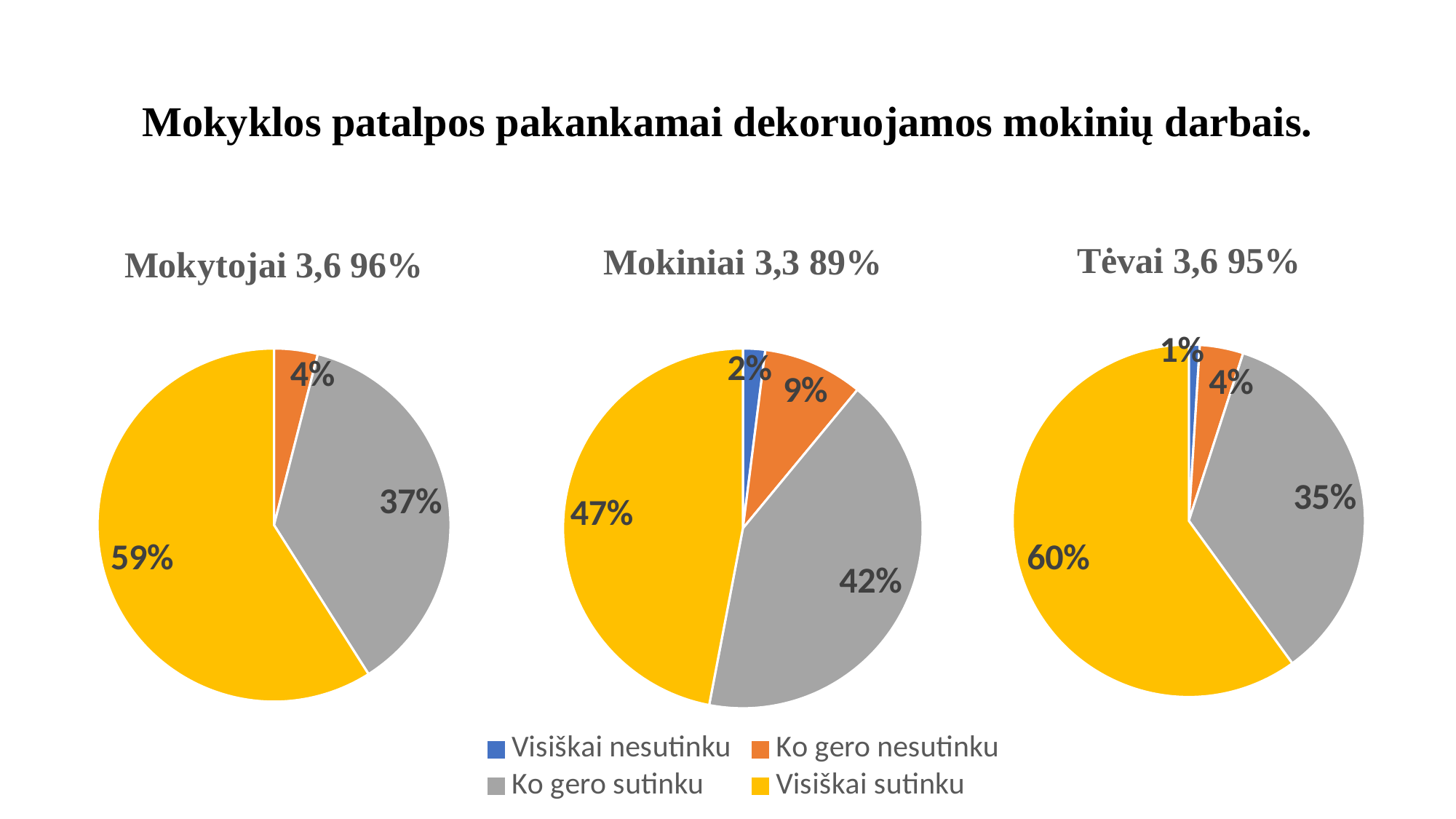
In the Tėvai pie chart, what share is labelled for Visiškai nesutinku? 1% In the Mokiniai pie chart, what share is labelled for Ko gero sutinku? 42% How many entries does the legend list? 4 How many slices with labels does the Mokiniai pie chart have? 4 In the Mokiniai pie chart, which category has the largest slice? Visiškai sutinku In the Mokytojai pie chart, what is the difference between the Visiškai sutinku and Ko gero sutinku shares? 22 percentage points In the Mokytojai pie chart, what share is labelled for Visiškai sutinku? 59% What is the title of the slide? Mokyklos patalpos pakankamai dekoruojamos mokinių darbais. Which colour represents Ko gero sutinku in the legend? Grey What kind of chart is used for the Tėvai data? Pie chart In the Mokiniai pie chart, which is larger: Ko gero nesutinku or Visiškai nesutinku? Ko gero nesutinku In the Tėvai pie chart, which category has the smallest slice? Visiškai nesutinku